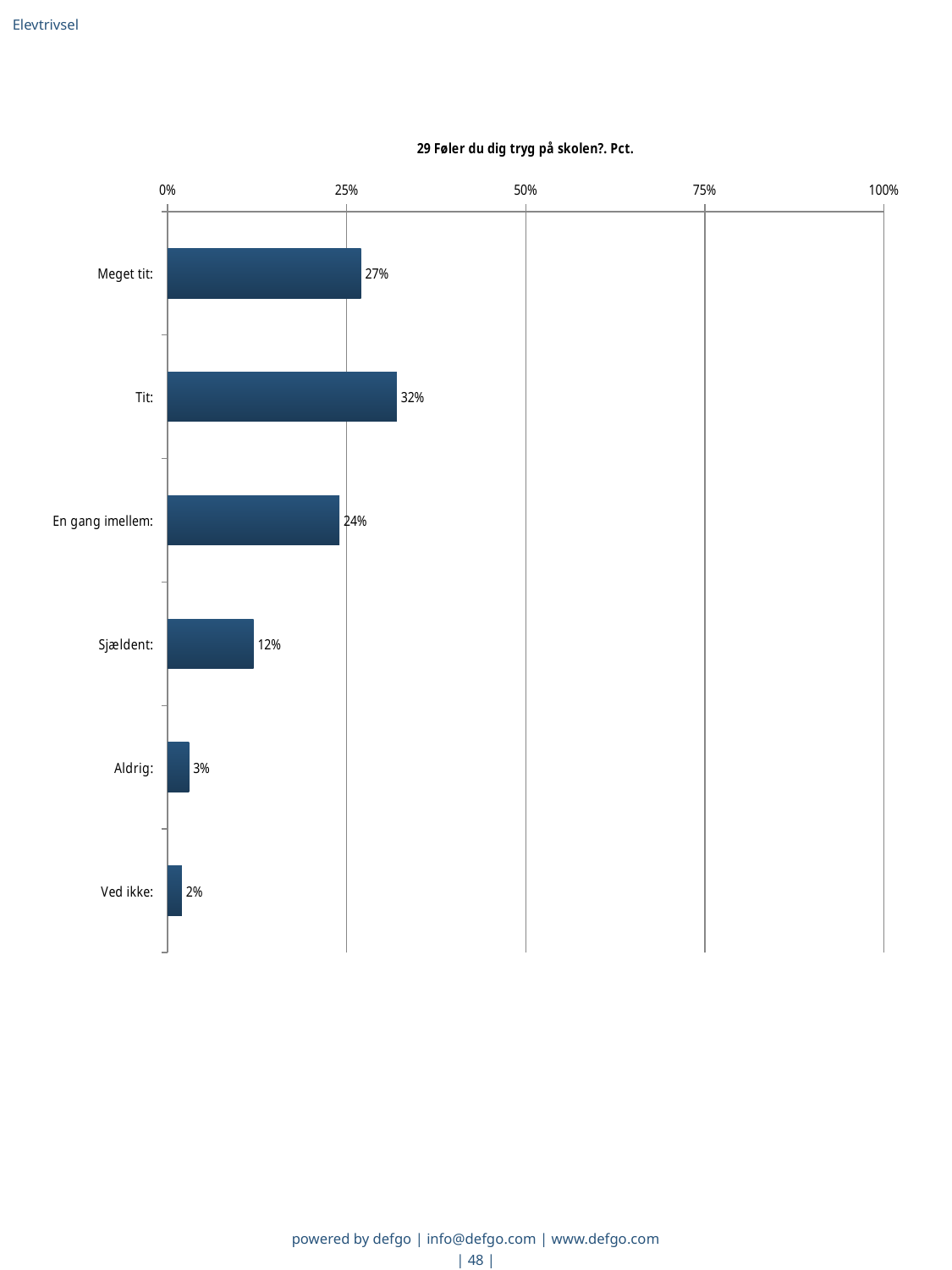
What is the title of the chart? 29 Føler du dig tryg på skolen?. Pct. Is the value for "Tit:" greater or less than 25%? greater Which category has the lowest value? Ved ikke: Which category has the highest value? Tit: How many categories are shown in the chart? 6 What is the value for "Tit:"? 32% What is the value for "Sjældent:"? 12% What is the difference between the values for "Aldrig:" and "Ved ikke:"? 1% What is the difference between the values for "Tit:" and "Meget tit:"? 5% Which is larger, the value for "Meget tit:" or the value for "En gang imellem:"? Meget tit: What is the value for "Ved ikke:"? 2% What kind of chart is shown on the slide? bar chart